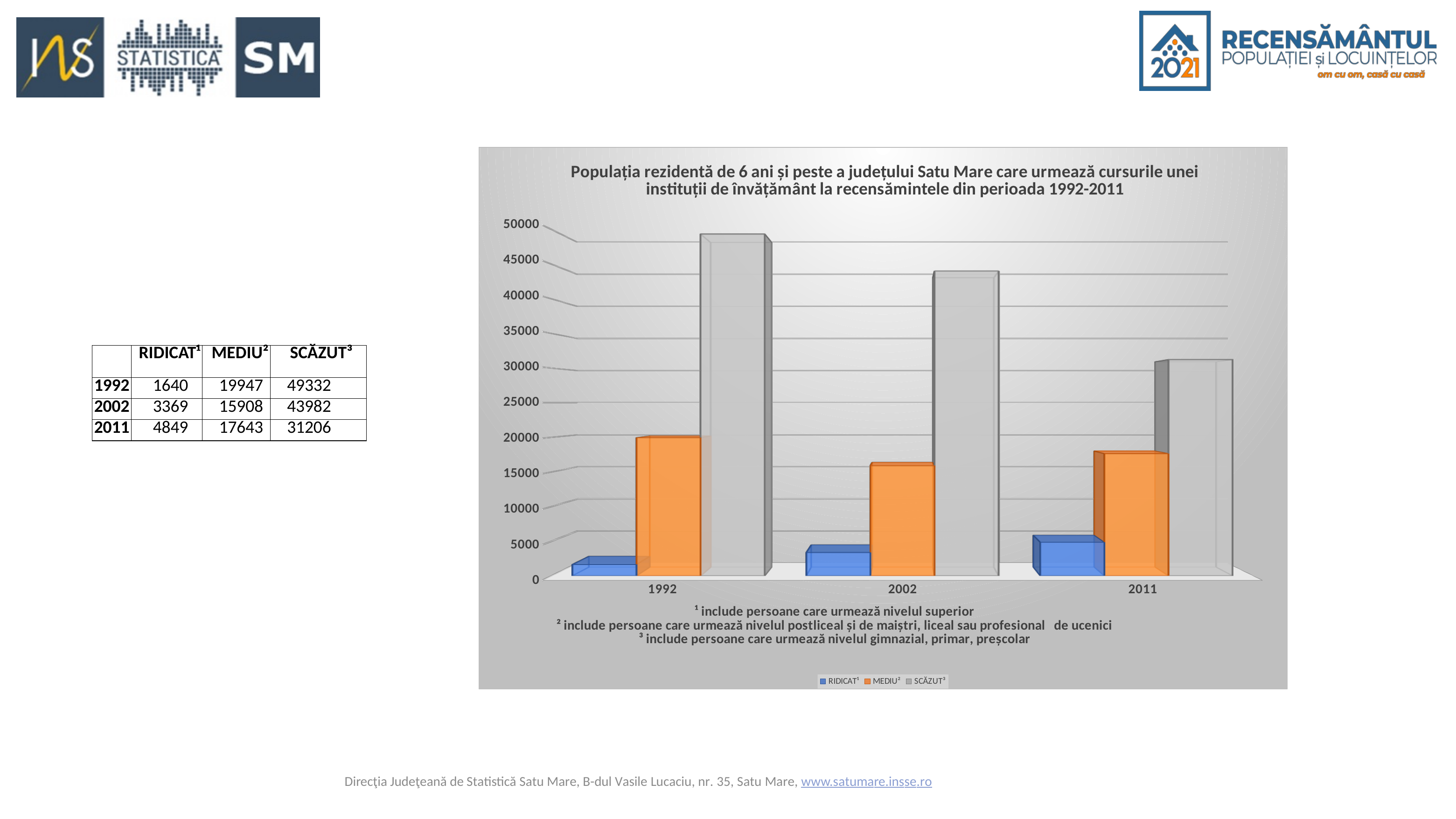
How many census years are shown on the x axis of the chart? 3 According to the table on the slide, what is the SCĂZUT value for 1992? 49332 Is the SCĂZUT value for 2011 greater or less than 30000? greater According to the table on the slide, what is the MEDIU value for 2002? 15908 In which year is the SCĂZUT bar the highest? 1992 According to the table on the slide, what is the RIDICAT value for 2011? 4849 How many series does the chart legend list? 3 What kind of chart is shown on the slide? bar chart Which is larger, the MEDIU value for 1992 or the MEDIU value for 2011? MEDIU for 1992 Do the RIDICAT values rise or fall from 1992 to 2011? rise In which year is the RIDICAT bar the lowest? 1992 Using the values in the table, what is the difference between the SCĂZUT values for 1992 and 2011? 18126